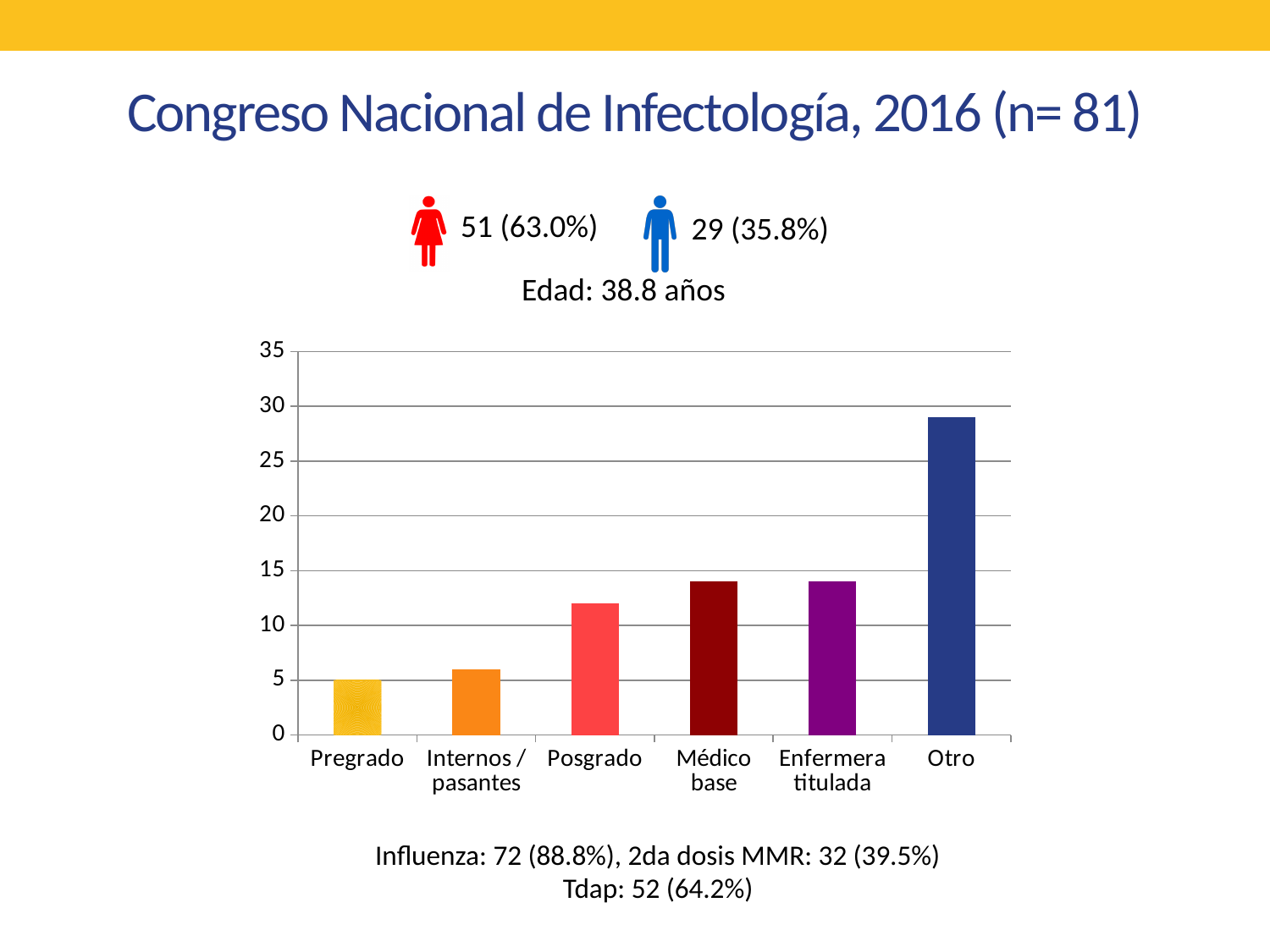
Is the value for Internos / pasantes greater or less than 10? less Which category has the lowest bar in the chart? Pregrado What is the value for Pregrado in the chart? 5 How many categories are shown on the x axis of the chart? 6 Is the value for Posgrado greater or less than 10? greater Is the value for Otro greater or less than 25? greater Which category has the highest bar in the chart? Otro Which is larger, the value for Otro or the value for Posgrado? Otro Do the bar values generally rise or fall from left to right along the x axis? Rise What colour is the bar for Otro? Dark blue What kind of chart is shown on the slide? Bar chart